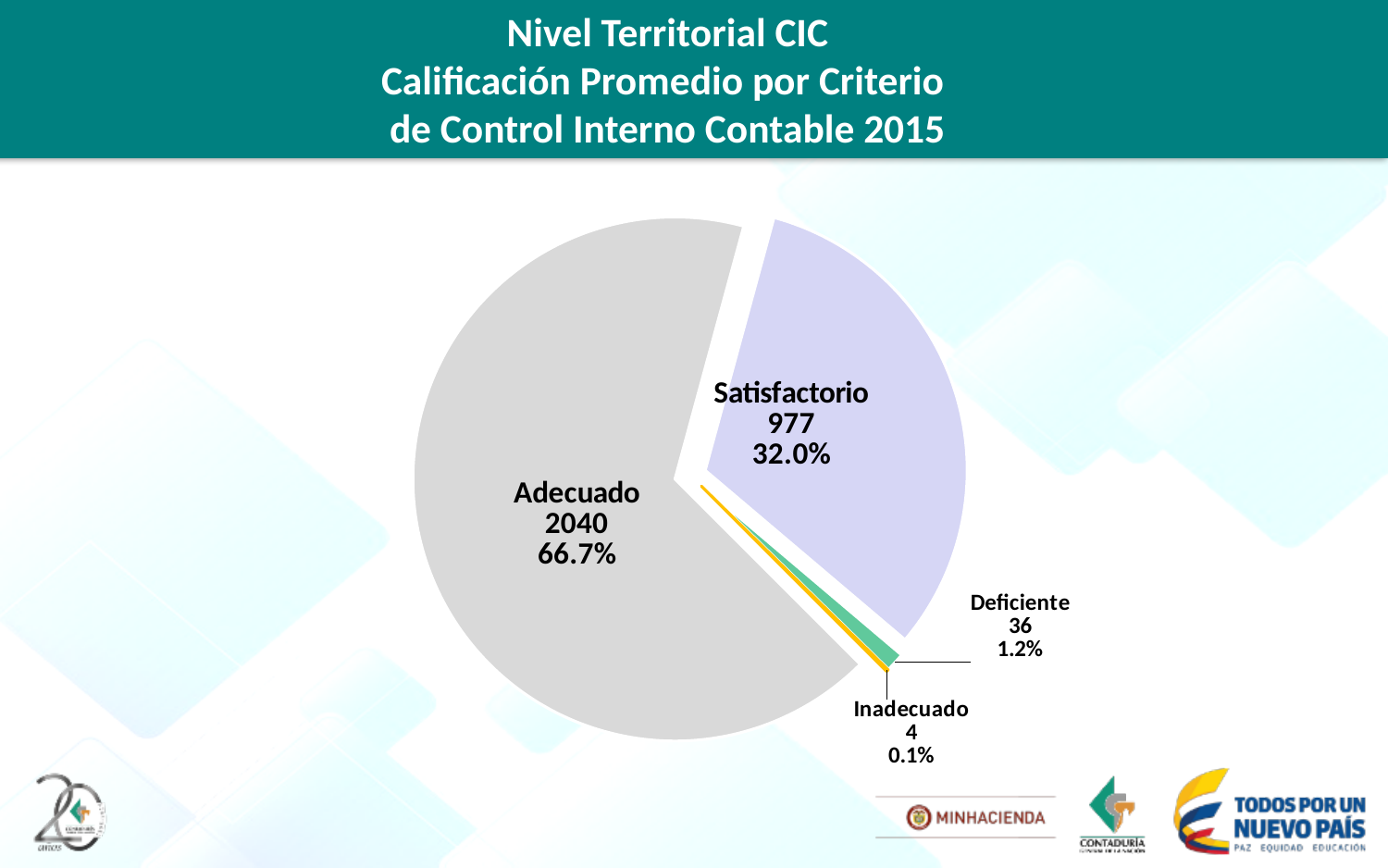
What kind of chart is shown on the slide? pie chart Which category has the largest slice? Adecuado Which category has the smallest slice? Inadecuado What is the value shown for Satisfactorio? 977 What share of the pie does Adecuado represent? 66.7% What is the value shown for Adecuado? 2040 What is the value shown for Inadecuado? 4 What share of the pie does Satisfactorio represent? 32.0% What is the difference between the values for Adecuado and Satisfactorio? 1063 Which is larger, the value for Deficiente or the value for Inadecuado? Deficiente How many slices does the pie chart have? 4 What is the value shown for Deficiente? 36